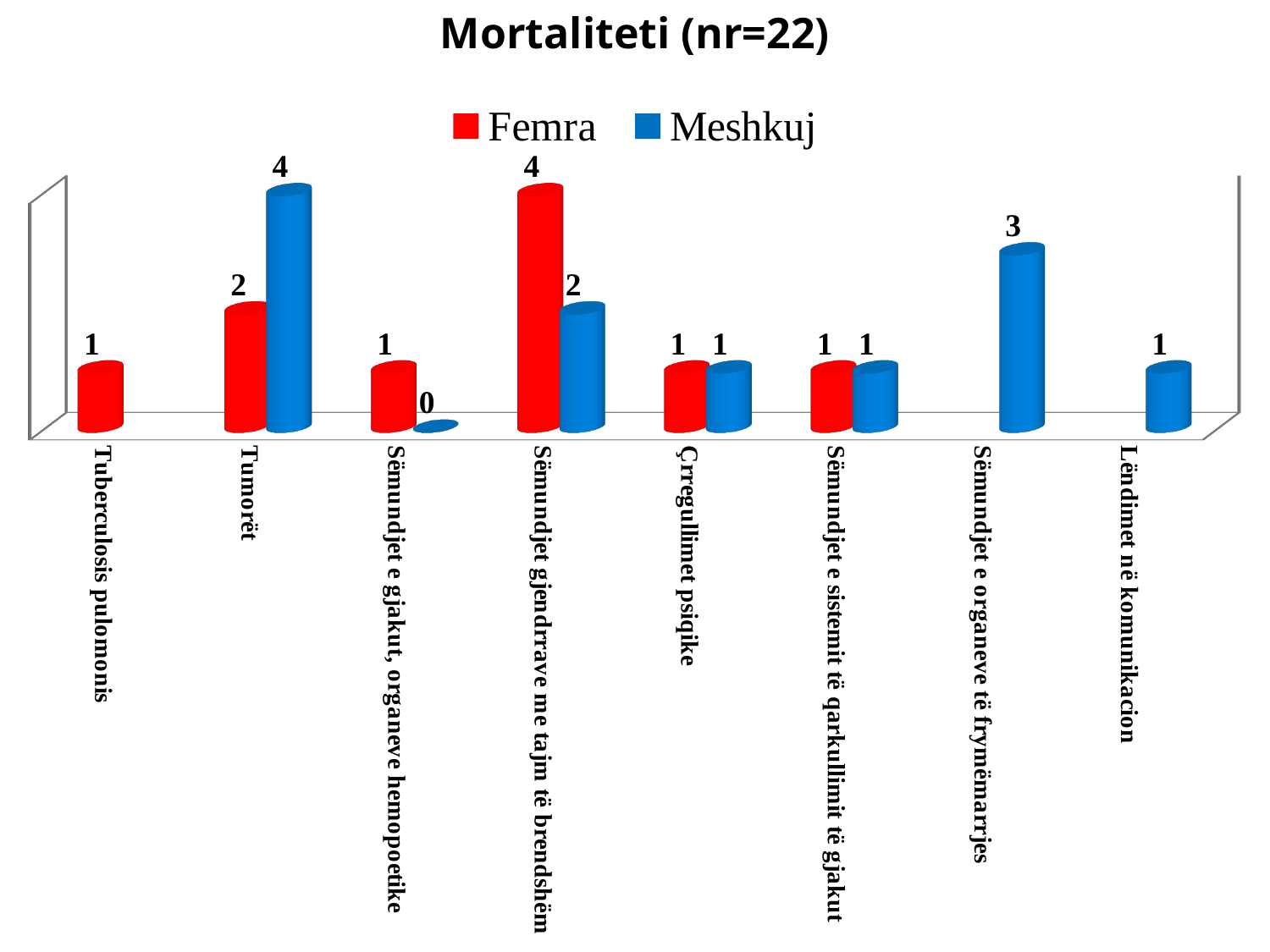
What is the title of the chart? Mortaliteti (nr=22) What is the Meshkuj value for Tumorët? 4 How many categories are shown on the x axis? 8 Which category has the highest Femra value? Sëmundjet gjendrrave me tajm të brendshëm What is the difference between the Meshkuj and Femra values for Tumorët? 2 How many series does the legend list? 2 What type of chart is shown on the slide? bar chart What is the Meshkuj value for Sëmundjet e gjakut, organeve hemopoetike? 0 What is the Meshkuj value for Sëmundjet e organeve të frymëmarrjes? 3 What is the Femra value for Sëmundjet gjendrrave me tajm të brendshëm? 4 For Sëmundjet gjendrrave me tajm të brendshëm, which is larger, the Femra value or the Meshkuj value? Femra Which category has the highest Meshkuj value? Tumorët